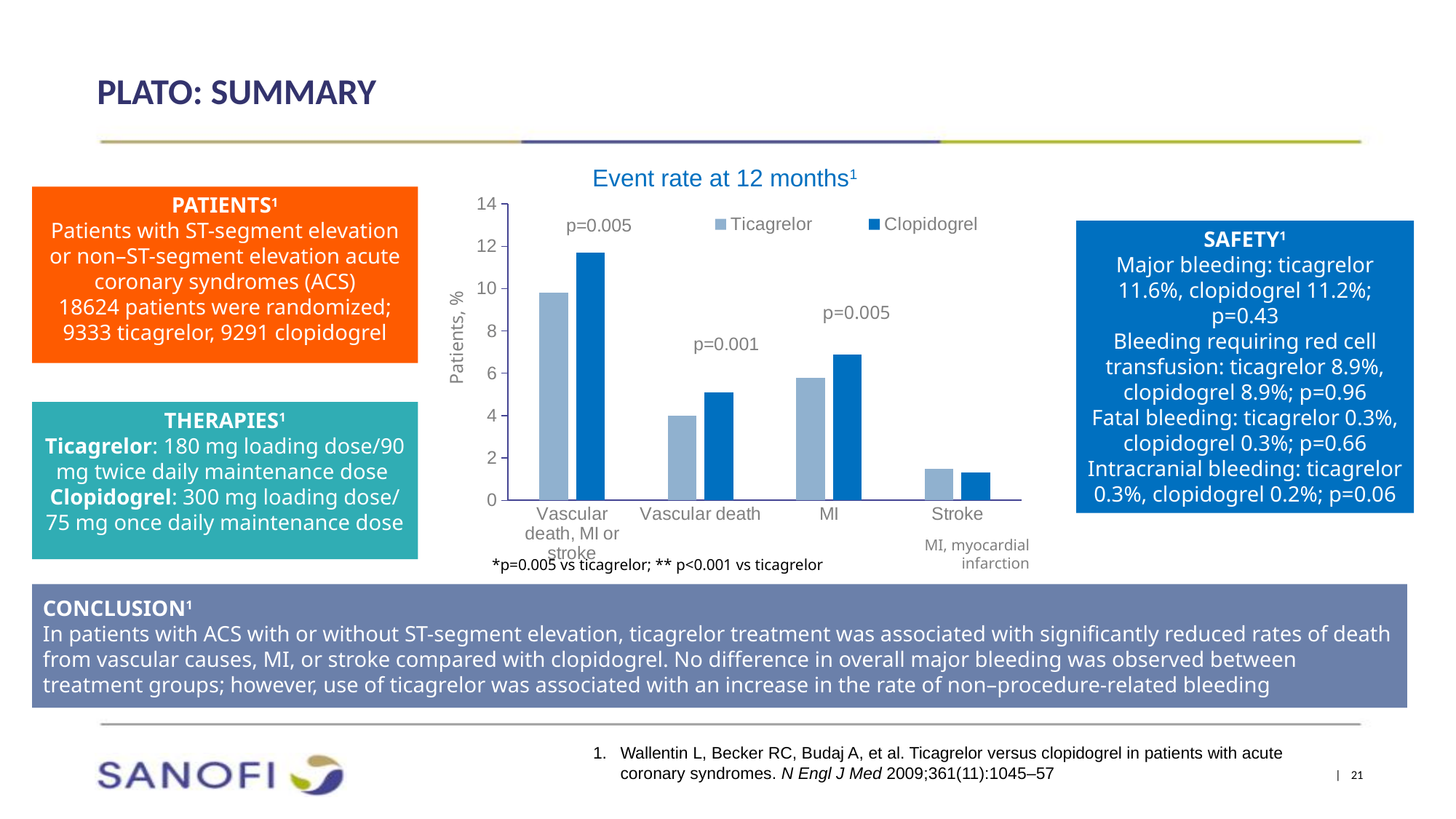
What kind of chart is shown under the title "Event rate at 12 months"? bar chart In the "Event rate at 12 months" chart, which category has the lowest event rates for both treatments? Stroke In the "Event rate at 12 months" chart, which category has the highest event rate for clopidogrel? Vascular death, MI or stroke In the "Event rate at 12 months" chart, is the ticagrelor value for "Vascular death" greater or less than 6? less In the "Event rate at 12 months" chart, which treatment has the higher event rate for "Vascular death", ticagrelor or clopidogrel? Clopidogrel In the "Event rate at 12 months" chart, is the ticagrelor value for "Vascular death, MI or stroke" greater or less than 8? greater What is the y-axis label of the "Event rate at 12 months" chart? Patients, % In the "Event rate at 12 months" chart, is the clopidogrel value for "Stroke" greater or less than 2? less How many series does the legend of the "Event rate at 12 months" chart list? 2 In the "Event rate at 12 months" chart, which treatment has the higher event rate for MI, ticagrelor or clopidogrel? Clopidogrel How many categories are shown on the x axis of the "Event rate at 12 months" chart? 4